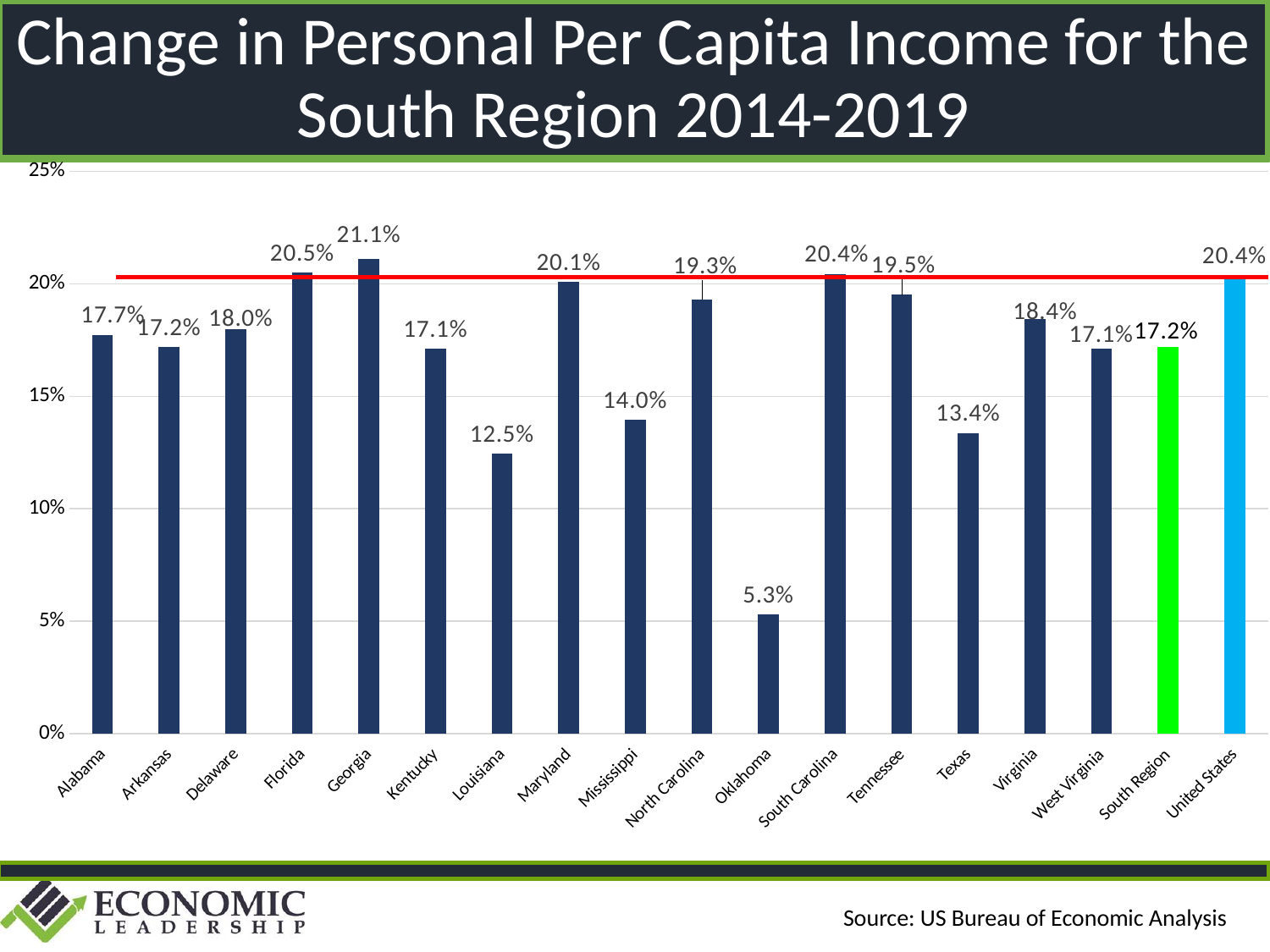
What is the difference between the values for Georgia and Oklahoma? 15.8% Which category has the highest value? Georgia Which category has the lowest value? Oklahoma Which has a larger value, Louisiana or Texas? Texas What is the value for the South Region bar? 17.2% Is the value for Mississippi greater or less than 15%? less What is the value for Oklahoma? 5.3% What is the difference between the United States value and the South Region value? 3.2% How many categories are shown on the x axis? 18 What is the value for the United States bar? 20.4% What kind of chart is shown on the slide? bar chart What is the value for Georgia? 21.1%